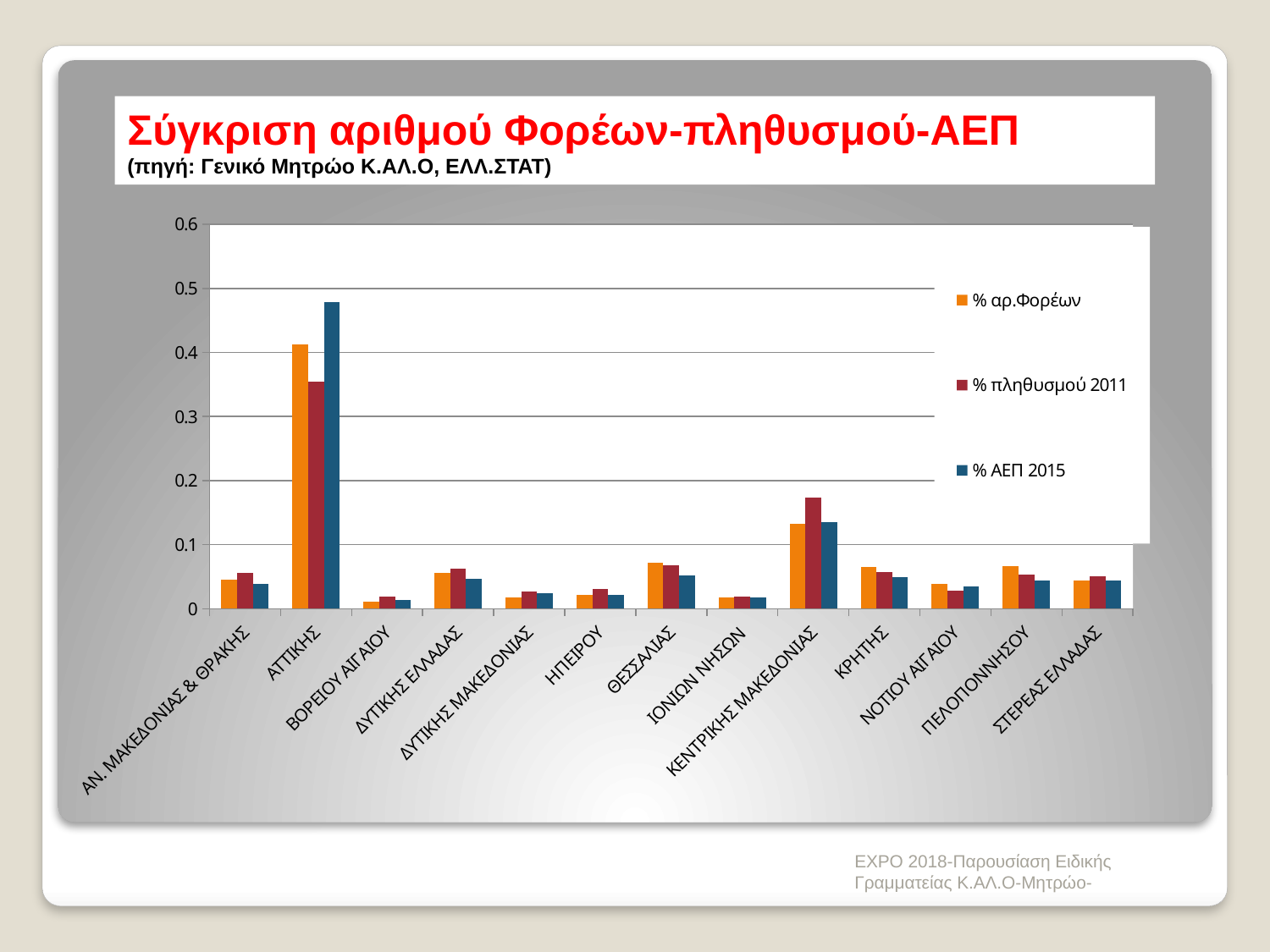
Which series is shown in blue in the chart's legend? % ΑΕΠ 2015 Is the value for % πληθυσμού 2011 in ΚΕΝΤΡΙΚΗΣ ΜΑΚΕΔΟΝΙΑΣ greater or less than 0.2? less Which region has the highest value for % ΑΕΠ 2015? ΑΤΤΙΚΗΣ Is the value for % ΑΕΠ 2015 in ΑΤΤΙΚΗΣ greater or less than 0.4? greater How many series does the chart's legend list? 3 What is the title of the chart on the slide? Σύγκριση αριθμού Φορέων-πληθυσμού-ΑΕΠ For ΑΤΤΙΚΗΣ, which is larger: % ΑΕΠ 2015 or % πληθυσμού 2011? % ΑΕΠ 2015 For ΚΕΝΤΡΙΚΗΣ ΜΑΚΕΔΟΝΙΑΣ, which is larger: % πληθυσμού 2011 or % αρ.Φορέων? % πληθυσμού 2011 Is the value for % πληθυσμού 2011 in ΑΤΤΙΚΗΣ greater or less than 0.3? greater Which region has the highest value for % αρ.Φορέων? ΑΤΤΙΚΗΣ What kind of chart is shown on the slide? Bar chart How many regions (categories) are shown on the x axis of the chart? 13